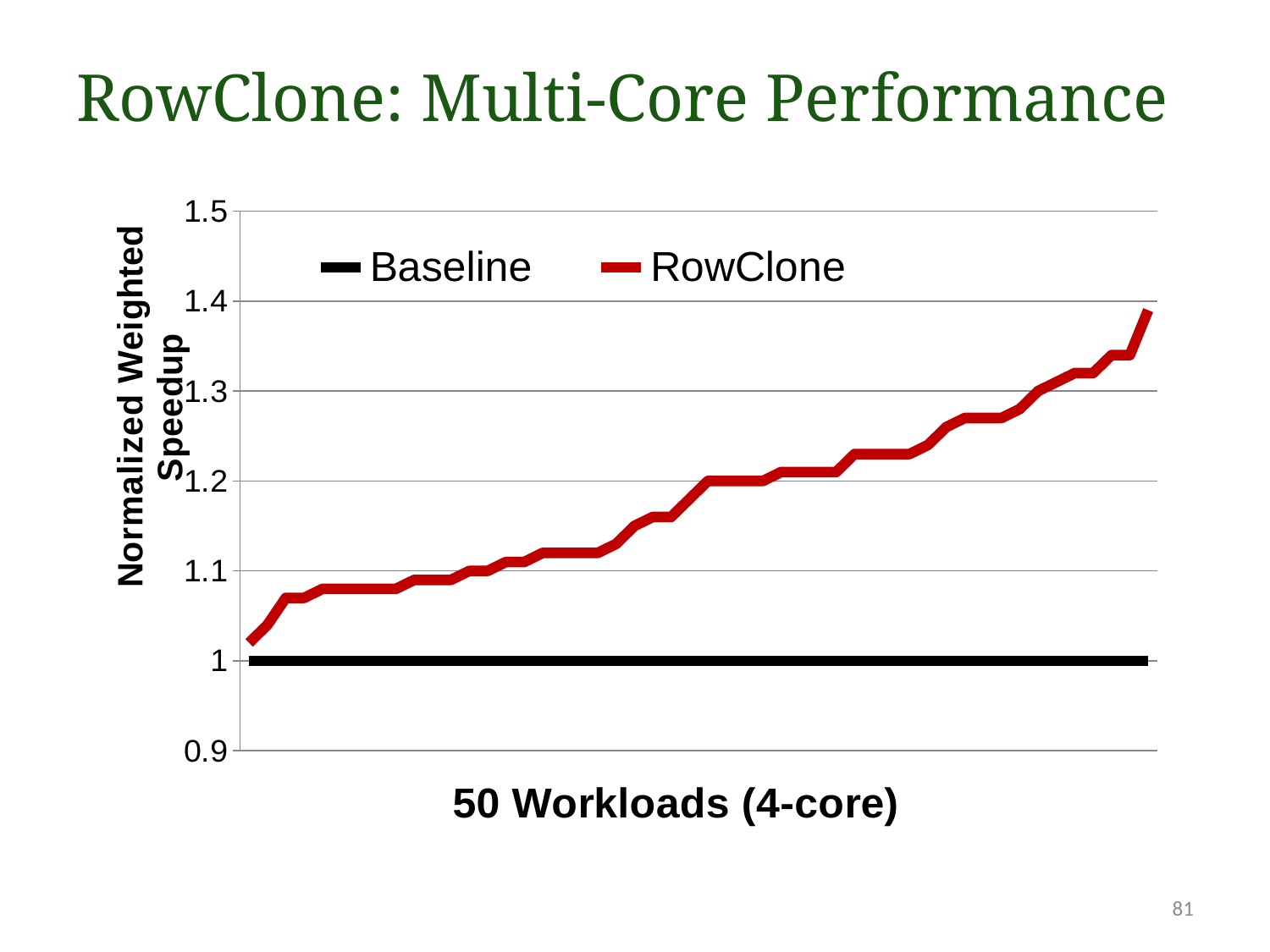
Is the highest value of the RowClone series greater or less than 1.3? greater What are the two series named in the legend? Baseline and RowClone Does the RowClone series rise or fall as you move from left to right along the x axis? rise How many workloads does the x axis label say are plotted? 50 Is the lowest value of the RowClone series greater or less than 1.1? less What kind of chart is shown on the slide? line chart Which series has the higher normalized weighted speedup, Baseline or RowClone? RowClone How many series does the legend list? 2 What is the normalized weighted speedup of the Baseline series across all workloads? 1 What is the label on the y axis? Normalized Weighted Speedup Is the Baseline series greater or less than 1.1? less What is the title of the slide's chart? RowClone: Multi-Core Performance